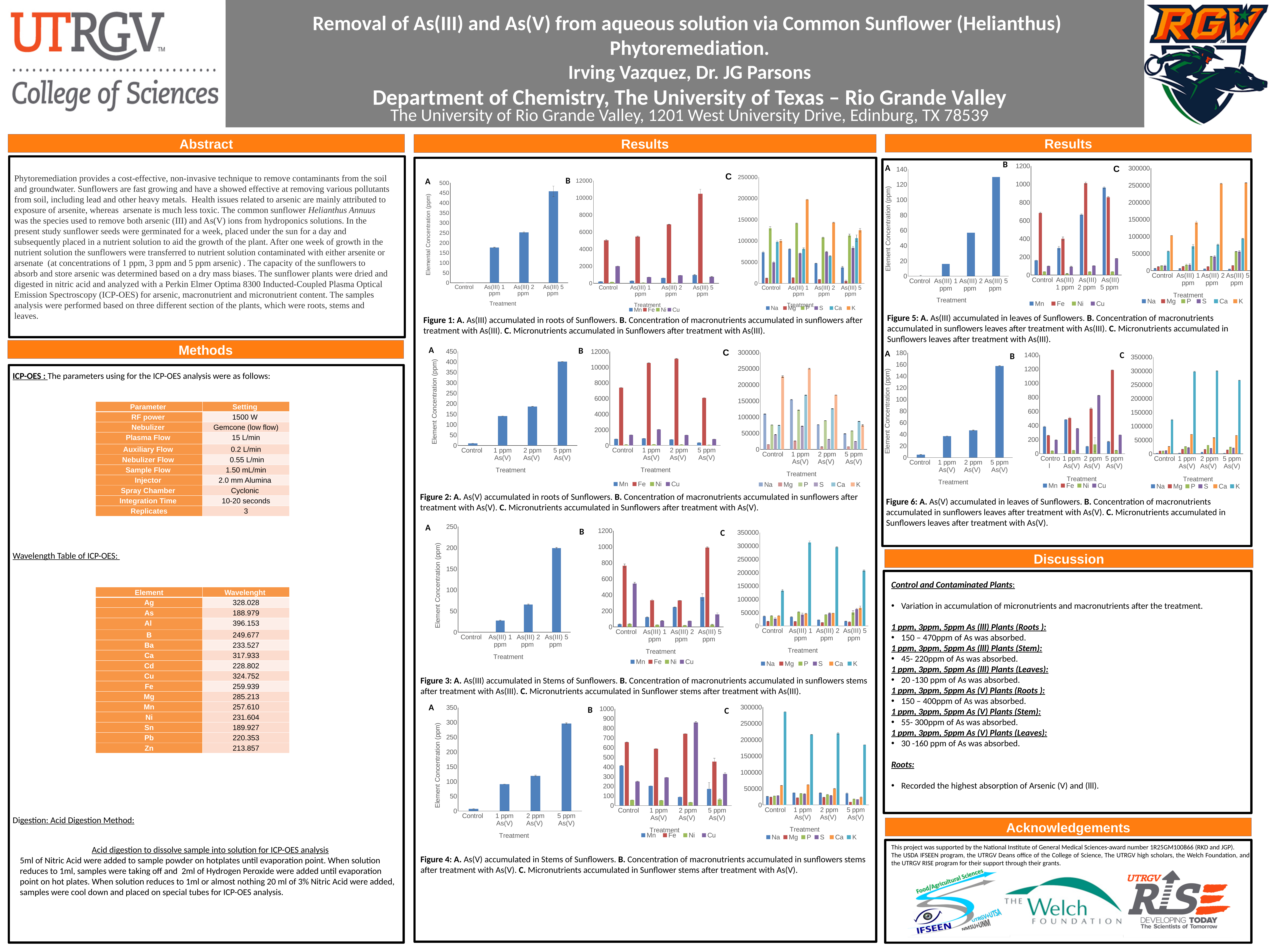
In Figure 2 panel A (As(V) in roots), do the values rise or fall from Control to 5 ppm As(V)? rise What kind of chart is Figure 6 panel A (As(V) in leaves)? bar chart In Figure 1 panel A (As(III) in roots), how many treatment categories are shown on the x axis? 4 In Figure 1 panel A (As(III) in roots), which treatment has the highest elemental concentration? As(III) 5 ppm In Figure 5 panel A (As(III) in leaves), is the value for As(III) 2 ppm greater or less than 40? greater In Figure 1 panel B (macronutrients in roots after As(III)), which element has the tallest bar for the As(III) 5 ppm treatment? Fe In Figure 1 panel C (micronutrients in roots after As(III)), how many series does the legend list? 6 In Figure 6 panel A (As(V) in leaves), which treatment has the lowest element concentration? Control In Figure 1 panel A (As(III) in roots), is the value for As(III) 5 ppm greater or less than 400? greater In Figure 1 panel B (macronutrients in roots after As(III)), how many series does the legend list? 4 In Figure 3 panel A (As(III) in stems), is the value for As(III) 5 ppm greater or less than 150? greater In Figure 4 panel A (As(V) in stems), which is larger, the value for 1 ppm As(V) or 2 ppm As(V)? 2 ppm As(V)